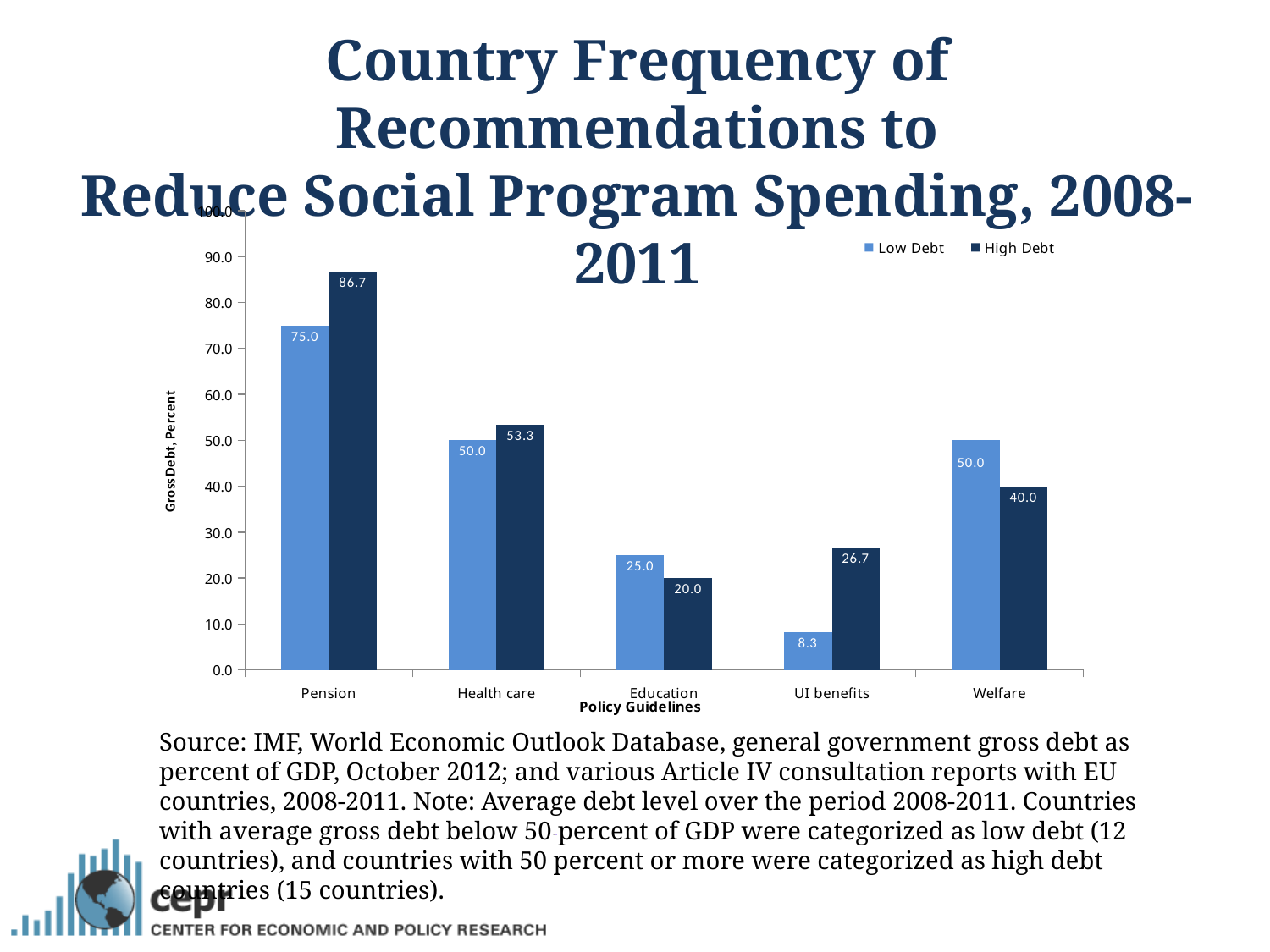
Which category has the highest High Debt value? Pension How many series does the legend list? 2 How many categories are shown on the x axis? 5 What kind of chart is shown on the slide? Bar chart What is the label of the y axis? Gross Debt, Percent For Education, which series has the larger value, Low Debt or High Debt? Low Debt What is the difference between the High Debt and Low Debt values for Pension? 11.7 Is the High Debt value for Health care greater or less than 50.0? greater What is the Low Debt value for Pension? 75.0 Which category has the lowest Low Debt value? UI benefits What is the High Debt value for UI benefits? 26.7 What is the High Debt value for Welfare? 40.0